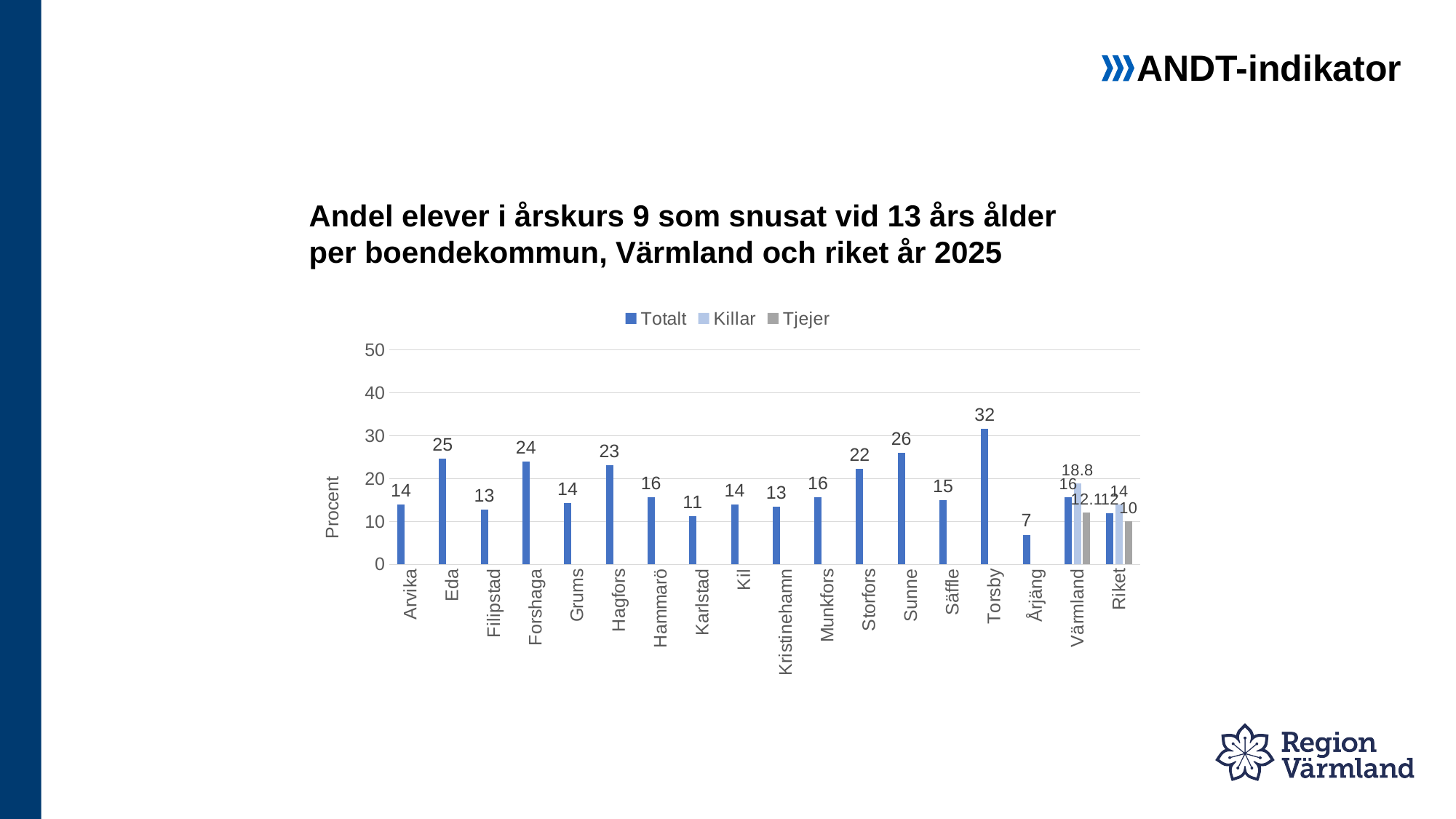
Which category has the highest Totalt value? Torsby What is the Killar value for Värmland? 18.8 What is the Totalt value for Torsby? 32 What is the label on the y axis? Procent Which has a higher Totalt value, Sunne or Hagfors? Sunne How many series does the legend list? 3 What is the difference between the Totalt values for Eda and Arvika? 11 What is the Tjejer value for Riket? 10 What kind of chart is shown on the slide? bar chart How many categories are shown on the x axis? 18 Is the Totalt value for Torsby greater or less than 30? greater Which category has the lowest Totalt value? Årjäng